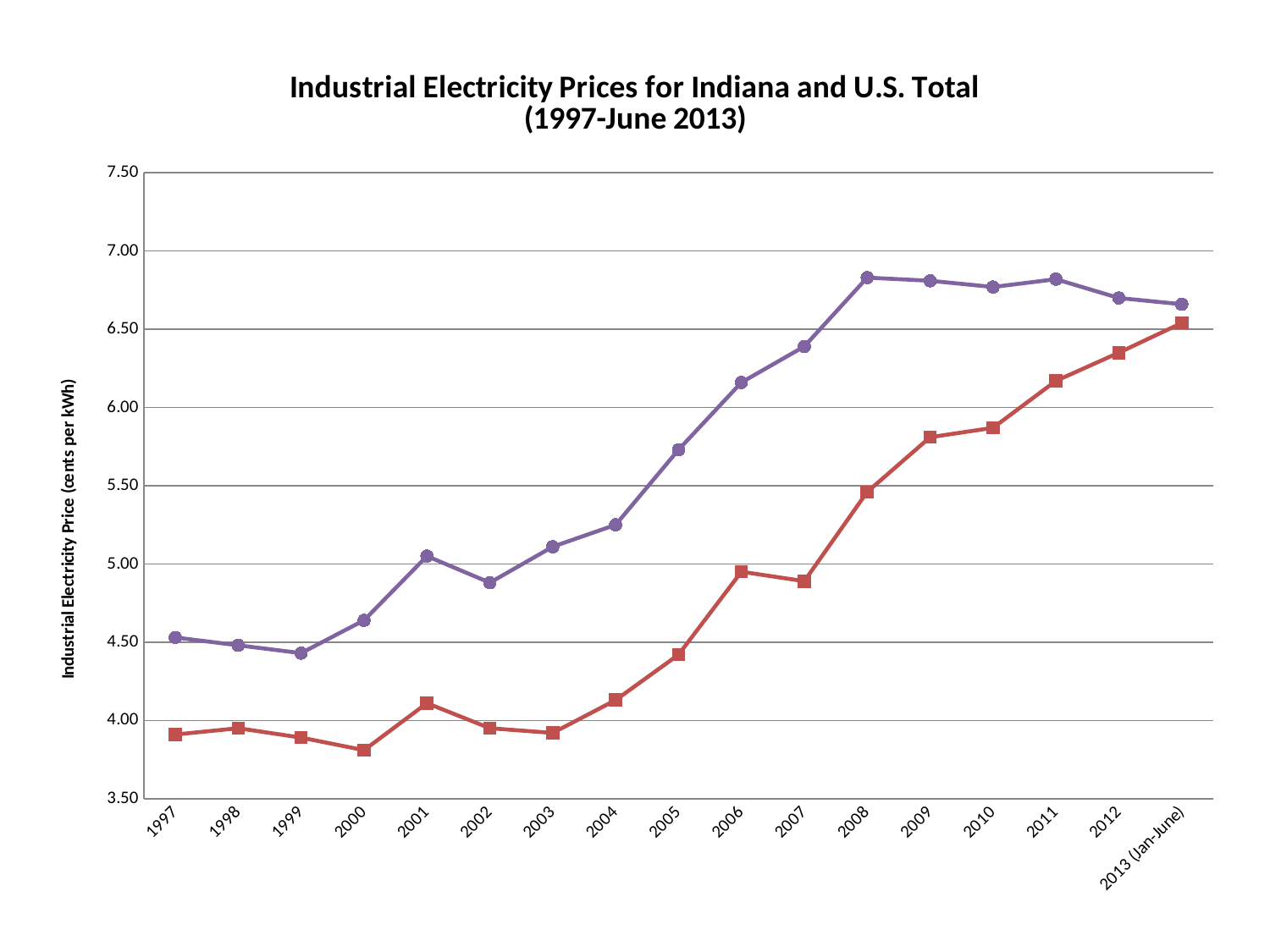
What is the title of the chart? Industrial Electricity Prices for Indiana and U.S. Total (1997-June 2013) Is the value of the red line (square markers) in 2000 greater or less than 4.00? less Is the value of the red line (square markers) in 2009 greater or less than 5.50? greater What kind of chart is shown on the slide? line chart In which period does the red line (square markers) reach its highest value? 2013 (Jan-June) Is the value of the purple line (circle markers) in 2002 greater or less than 5.00? less In which year does the red line (square markers) reach its lowest value? 2000 Which line is higher in 2008, the purple line or the red line? purple line What is the label on the y axis? Industrial Electricity Price (cents per kWh) How many time periods are plotted along the x axis? 17